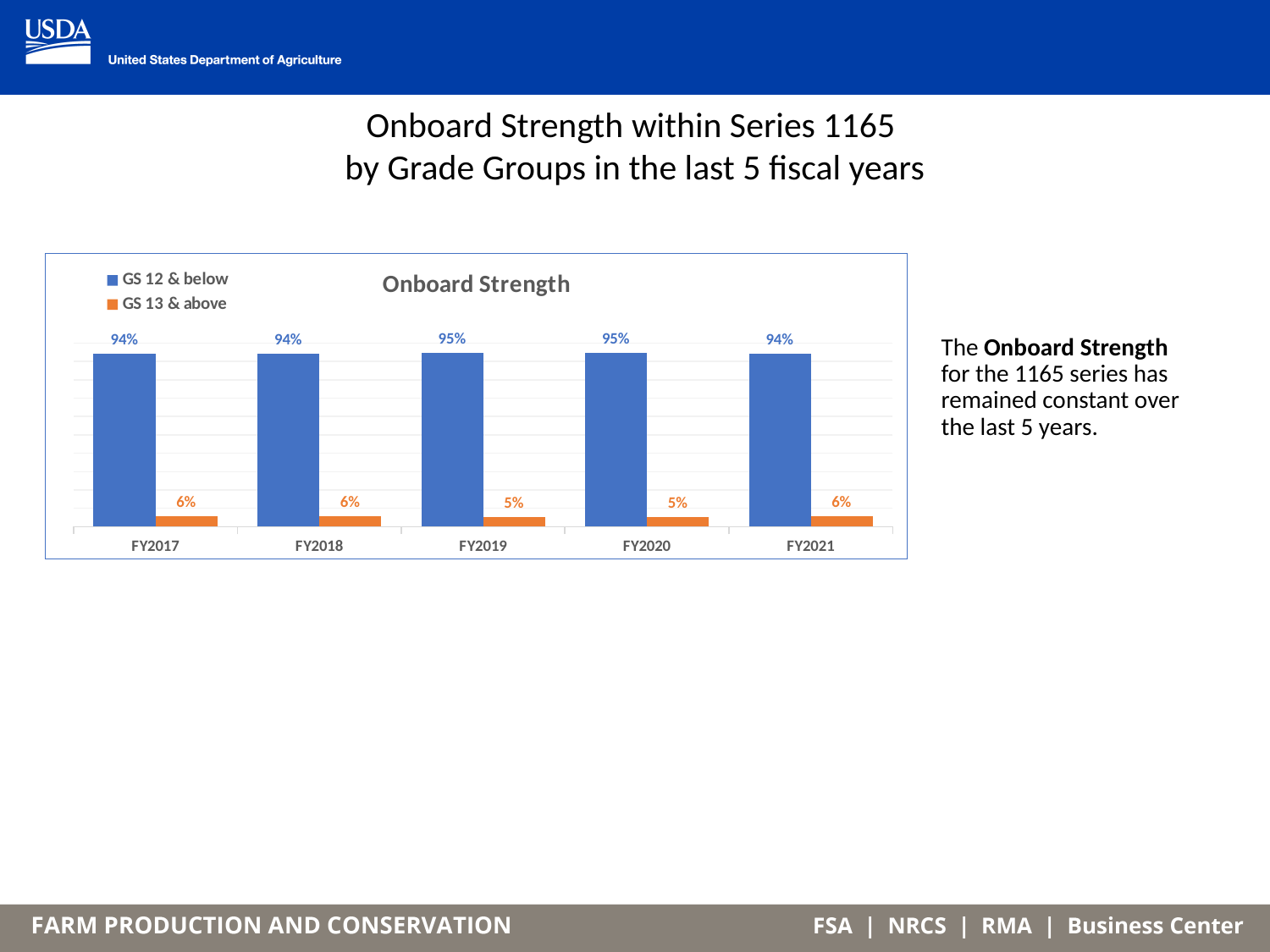
How many series does the legend list? 2 Which colour represents GS 13 & above in the chart? Orange What is the value for GS 12 & below in FY2021? 94% What kind of chart is shown? Bar chart How many fiscal years are shown on the x axis? 5 What is the value for GS 13 & above in FY2020? 5% What is the difference between the GS 12 & below and GS 13 & above values in FY2018? 88% What is the title of the chart? Onboard Strength What is the value for GS 13 & above in FY2017? 6% What is the total of the GS 12 & below and GS 13 & above values in FY2019? 100% Which is larger in FY2020, GS 12 & below or GS 13 & above? GS 12 & below What is the value for GS 12 & below in FY2019? 95%